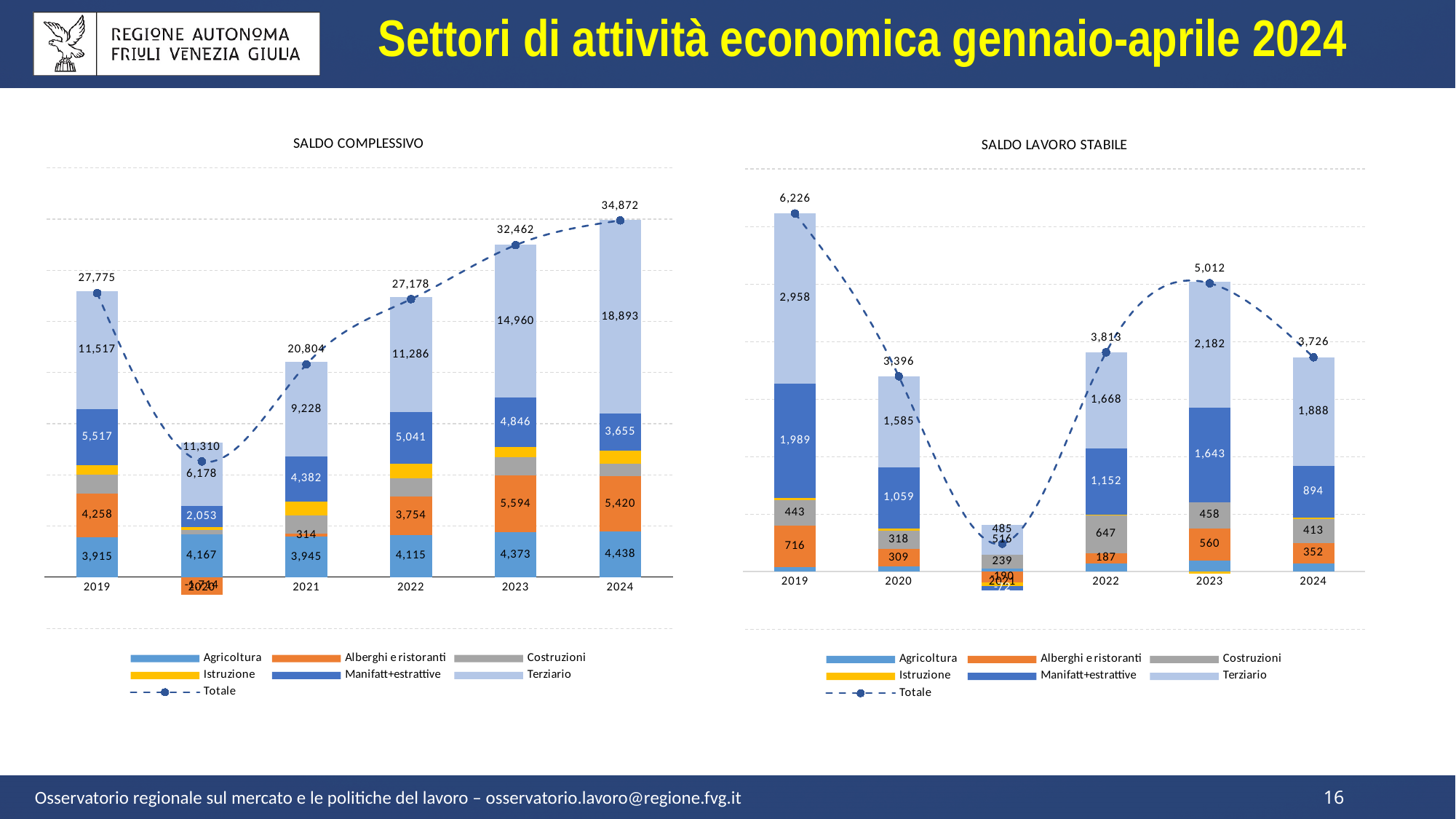
In the SALDO COMPLESSIVO chart, which year has the highest Totale? 2024 In the SALDO COMPLESSIVO chart, what is the Totale value for 2024? 34,872 How many years are shown on the x axis of the SALDO COMPLESSIVO chart? 6 In the SALDO LAVORO STABILE chart, which year has the lowest Totale? 2021 In the SALDO LAVORO STABILE chart, what is the Totale value for 2019? 6,226 How many entries does the legend of the SALDO LAVORO STABILE chart list? 7 In the SALDO COMPLESSIVO chart, what is the difference between the Terziario values for 2024 and 2023? 3,933 In the SALDO LAVORO STABILE chart, what is the difference between the Totale values for 2023 and 2024? 1,286 In the SALDO COMPLESSIVO chart, what is the Agricoltura value for 2019? 3,915 In the SALDO LAVORO STABILE chart, what is the Terziario value for 2023? 2,182 In the SALDO COMPLESSIVO chart, which year has the lowest Totale? 2020 In the SALDO LAVORO STABILE chart, is the Manifatt+estrattive value larger in 2019 or in 2024? 2019